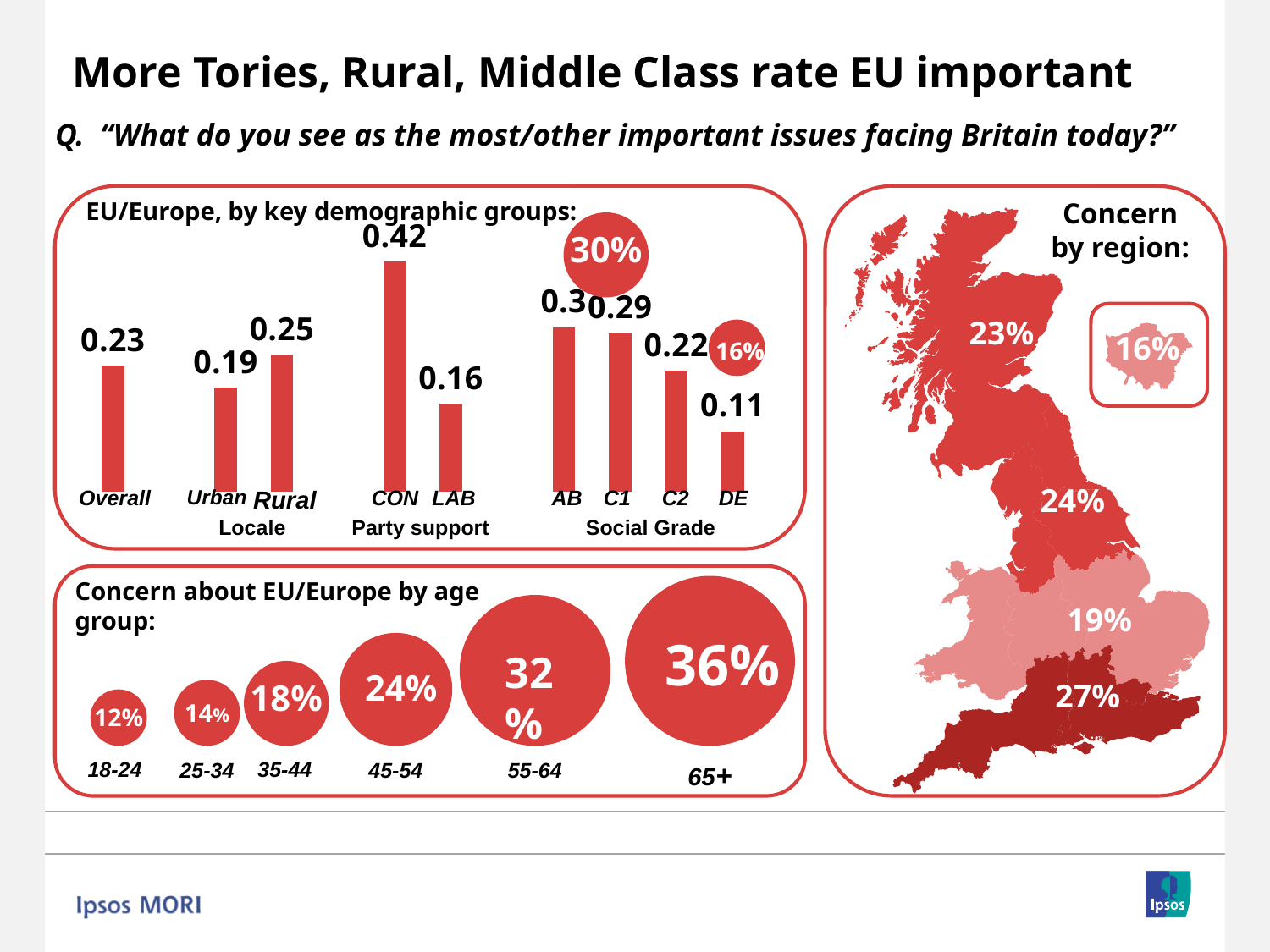
In the 'EU/Europe, by key demographic groups' chart, what is the value for CON? 0.42 In the 'Concern about EU/Europe by age group' chart, do the values rise or fall as age increases from 18-24 to 65+? rise In the 'EU/Europe, by key demographic groups' chart, which category has the highest value? CON In the 'EU/Europe, by key demographic groups' chart, which is larger, the value for Urban or the value for Rural? Rural In the 'EU/Europe, by key demographic groups' chart, what is the difference between the values for CON and LAB? 0.26 In the 'Concern by region' map, what is the value shown for London (the inset)? 16% In the 'EU/Europe, by key demographic groups' chart, what is the value for Overall? 0.23 In the 'EU/Europe, by key demographic groups' chart, how many bars are plotted? 9 What kind of chart is 'EU/Europe, by key demographic groups'? bar chart In the 'EU/Europe, by key demographic groups' chart, which category has the lowest value? DE In the 'Concern about EU/Europe by age group' chart, what is the difference between the values for 45-54 and 18-24? 12% In the 'Concern about EU/Europe by age group' chart, what is the value for the 65+ age group? 36%